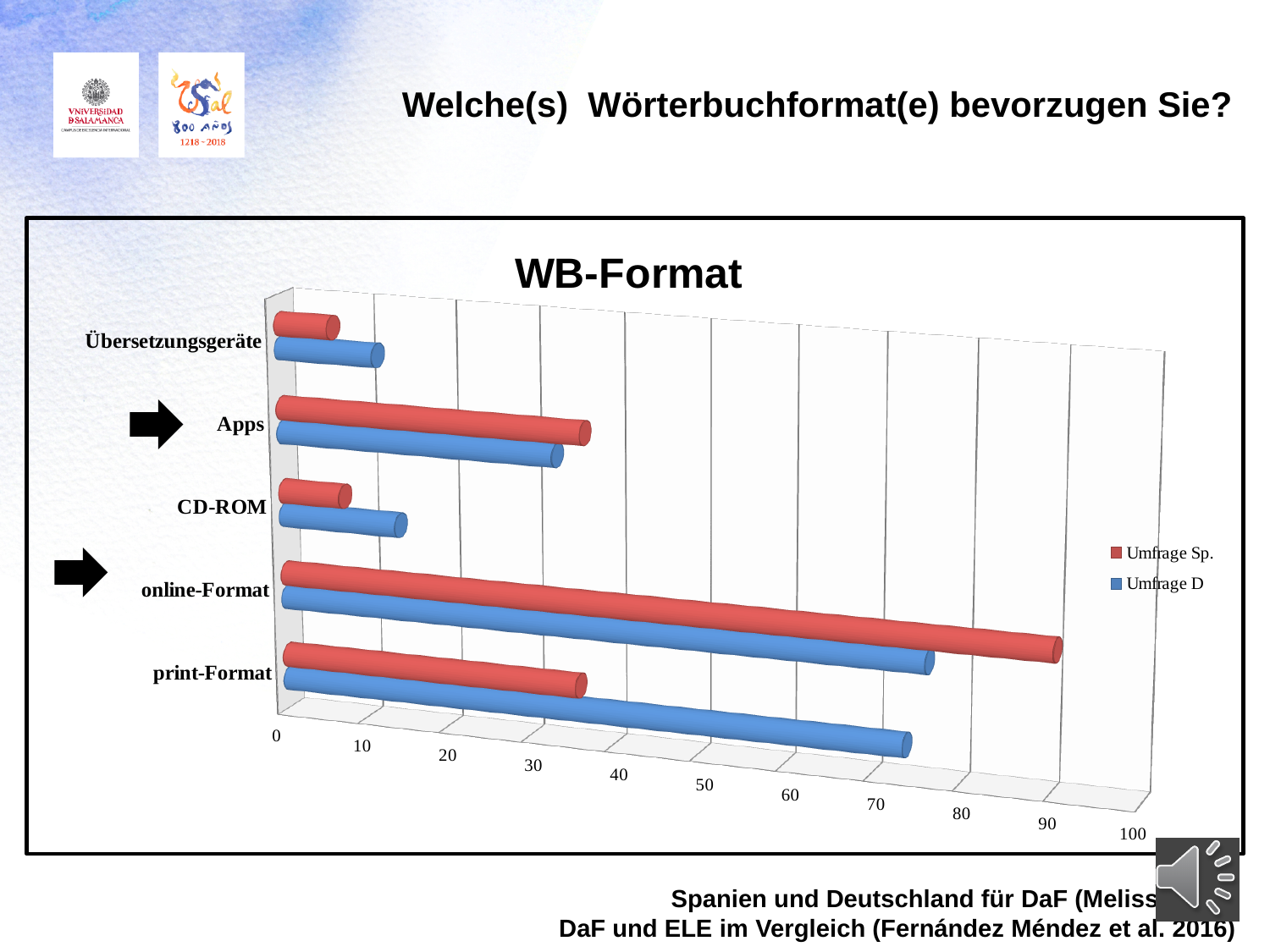
Which category has the highest value for Umfrage Sp.? online-Format What is the title of the chart? WB-Format For online-Format, which series has the larger value, Umfrage Sp. or Umfrage D? Umfrage Sp. How many series does the legend list? 2 Is the value for print-Format in the Umfrage D series greater or less than 60? greater For CD-ROM, which series has the larger value, Umfrage Sp. or Umfrage D? Umfrage D How many dictionary format categories are shown on the chart? 5 For print-Format, which series has the larger value, Umfrage Sp. or Umfrage D? Umfrage D Which series is shown in red? Umfrage Sp. Is the value for online-Format in the Umfrage Sp. series greater or less than 80? greater What kind of chart is shown on the slide? bar chart Is the value for Apps in the Umfrage Sp. series greater or less than 50? less